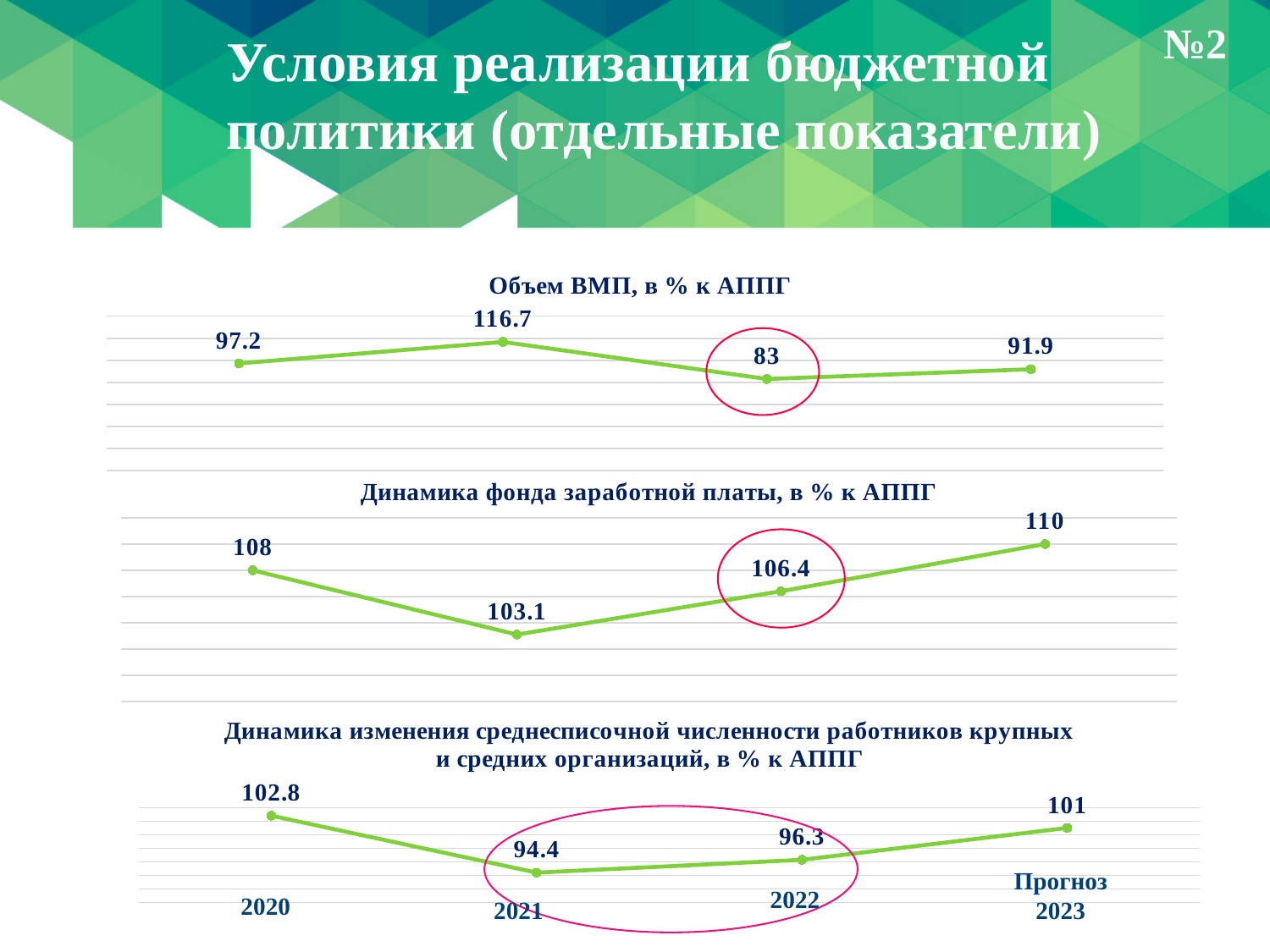
In the chart 'Динамика фонда заработной платы, в % к АППГ', what is the value of the last data point? 110 In the chart 'Объем ВМП, в % к АППГ', what is the difference between the highest value (116.7) and the lowest value (83)? 33.7 In the bottom chart on the slide (среднесписочная численность работников), do the values rise or fall from 2021 to Прогноз 2023? Rise In the chart 'Динамика фонда заработной платы, в % к АППГ', which is larger: the first value or the third value? The first value (108) What type of chart is 'Объем ВМП, в % к АППГ'? Line chart In the chart 'Динамика фонда заработной платы, в % к АППГ', how many data points are plotted? 4 In the chart 'Объем ВМП, в % к АППГ', what is the lowest value shown? 83 In the chart 'Объем ВМП, в % к АППГ', what is the value of the second data point? 116.7 In the bottom chart on the slide (среднесписочная численность работников), what is the value for 2021? 94.4 In the bottom chart on the slide (среднесписочная численность работников), what is the value for Прогноз 2023? 101 In the chart 'Динамика фонда заработной платы, в % к АППГ', which data point has the lowest value? The second point (103.1) In the bottom chart on the slide (среднесписочная численность работников), what is the difference between the 2020 value and the 2021 value? 8.4